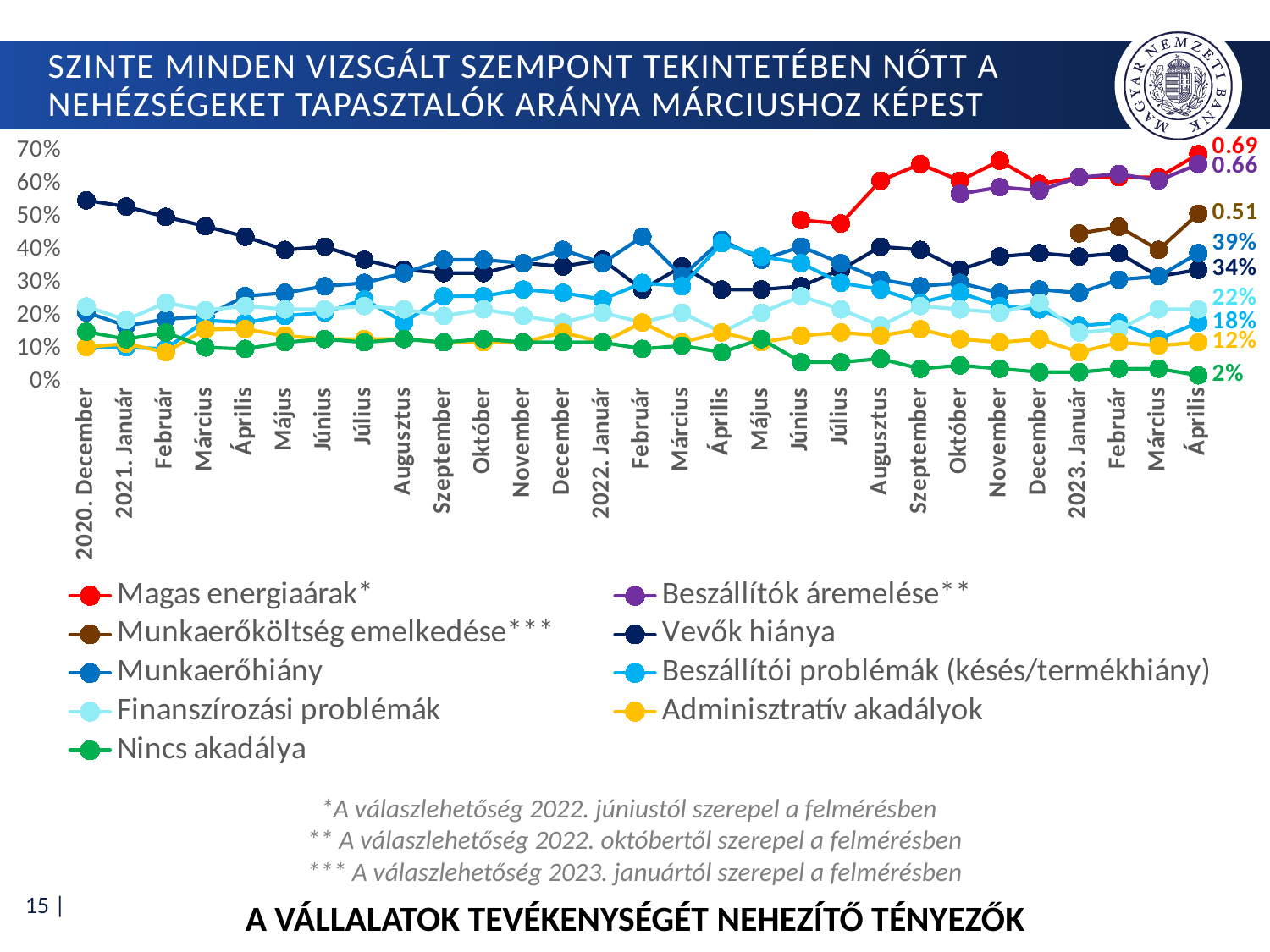
What is the value for Magas energiaárak at the last point (2023 Április)? 0.69 What is the difference between Munkaerőhiány (39%) and Vevők hiánya (34%) at the last point? 5 percentage points What is the value for Nincs akadálya at the last point (2023 Április)? 2% What type of chart is shown on the slide? line chart Does the Vevők hiánya series rise or fall from 2020 December to 2023 Április? fall Which series has the highest value at the last point (2023 Április)? Magas energiaárak At the last point, which is larger: Finanszírozási problémák or Adminisztratív akadályok? Finanszírozási problémák Which series has the lowest value at the last point (2023 Április)? Nincs akadálya What is the value for Munkaerőköltség emelkedése at the last point (2023 Április)? 0.51 What is the value for Munkaerőhiány at the last point (2023 Április)? 39% How many series does the legend list? 9 What is the value for Beszállítók áremelése at the last point (2023 Április)? 0.66